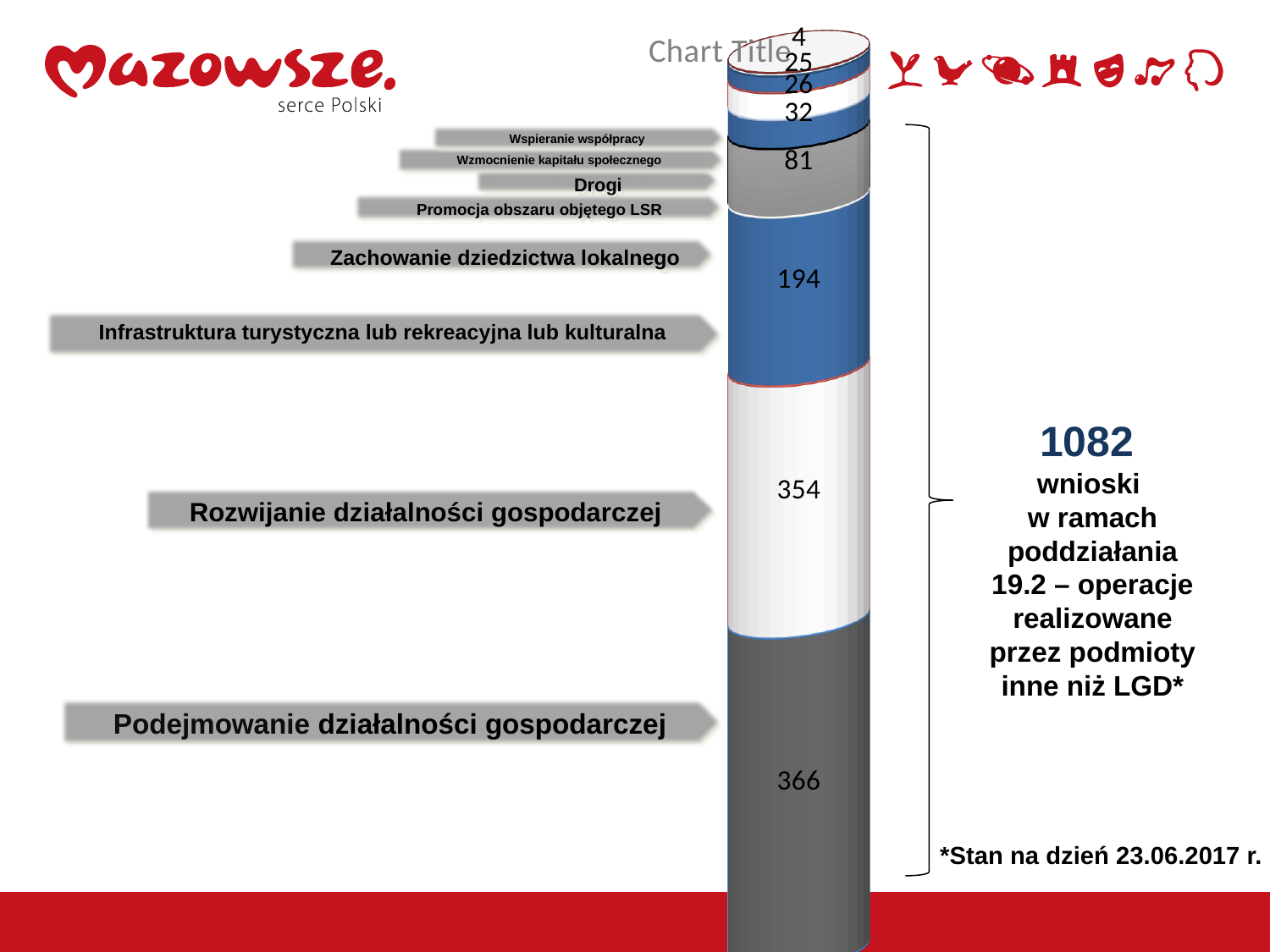
What value is shown for the Infrastruktura turystyczna lub rekreacyjna lub kulturalna segment? 194 Which segment of the stacked bar has the largest value? Podejmowanie działalności gospodarczej What value is shown for the Zachowanie dziedzictwa lokalnego segment? 81 Which segment of the stacked bar has the smallest value? Wspieranie współpracy What value is shown for the Podejmowanie działalności gospodarczej segment of the stacked bar? 366 What is the total of all segments in the stacked bar? 1082 How many segments make up the stacked bar? 8 Which is larger: the value for Promocja obszaru objętego LSR or the value for Wzmocnienie kapitału społecznego? Promocja obszaru objętego LSR What kind of chart is shown on the slide? Stacked bar chart What is the difference between the Podejmowanie działalności gospodarczej value and the Rozwijanie działalności gospodarczej value? 12 What value is shown for the Rozwijanie działalności gospodarczej segment? 354